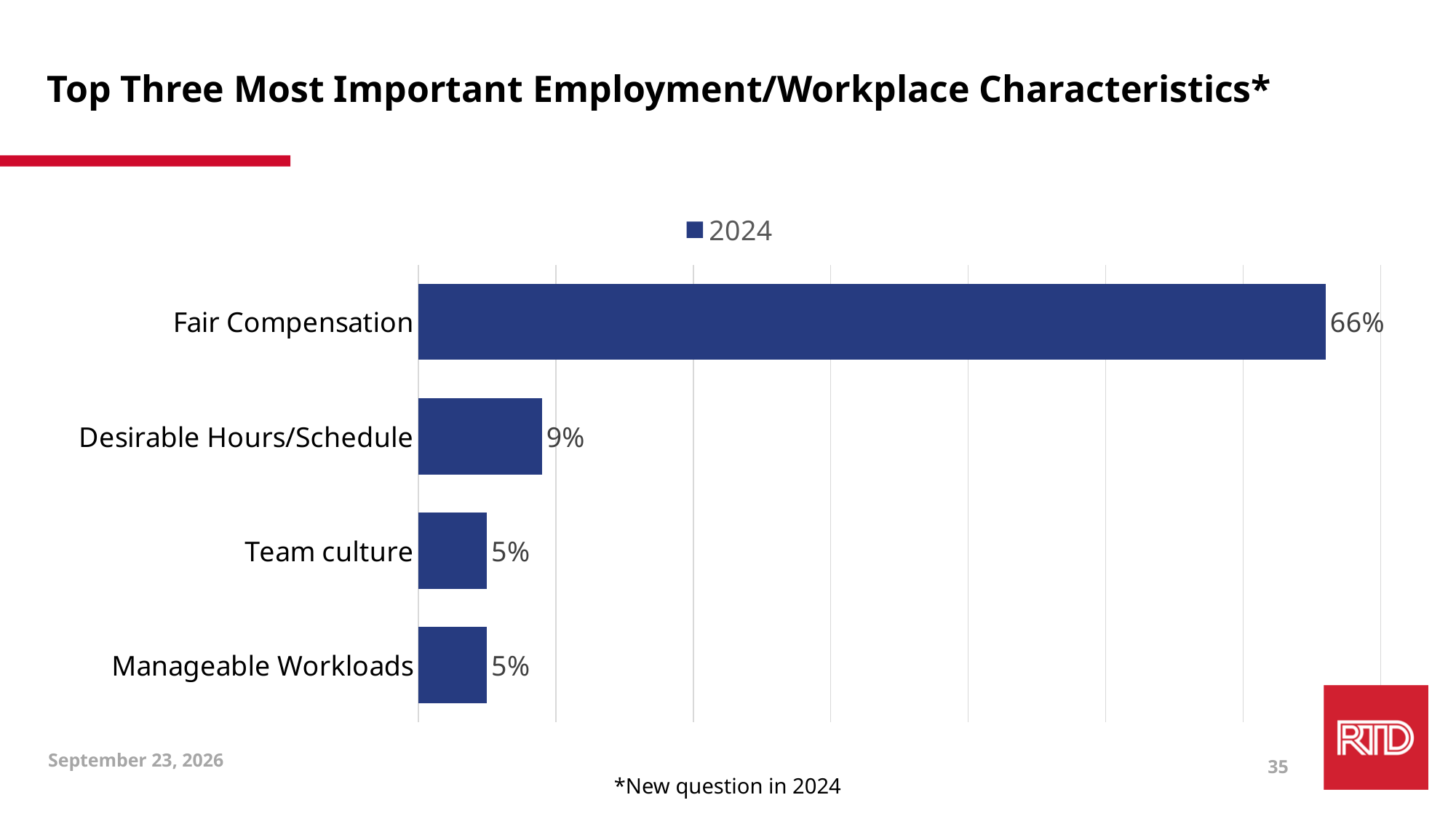
What is the value for Fair Compensation? 66% What is the value for Team culture? 5% What is the difference between the values for Desirable Hours/Schedule and Team culture? 4% What is the difference between the values for Fair Compensation and Desirable Hours/Schedule? 57% What is the value for Manageable Workloads? 5% What is the value for Desirable Hours/Schedule? 9% What kind of chart is shown on the slide? Bar chart Which category has the highest value? Fair Compensation How many series does the legend list? 1 Which is larger, the value for Fair Compensation or the value for Desirable Hours/Schedule? Fair Compensation How many categories are shown in the chart? 4 What series name is shown in the chart legend? 2024